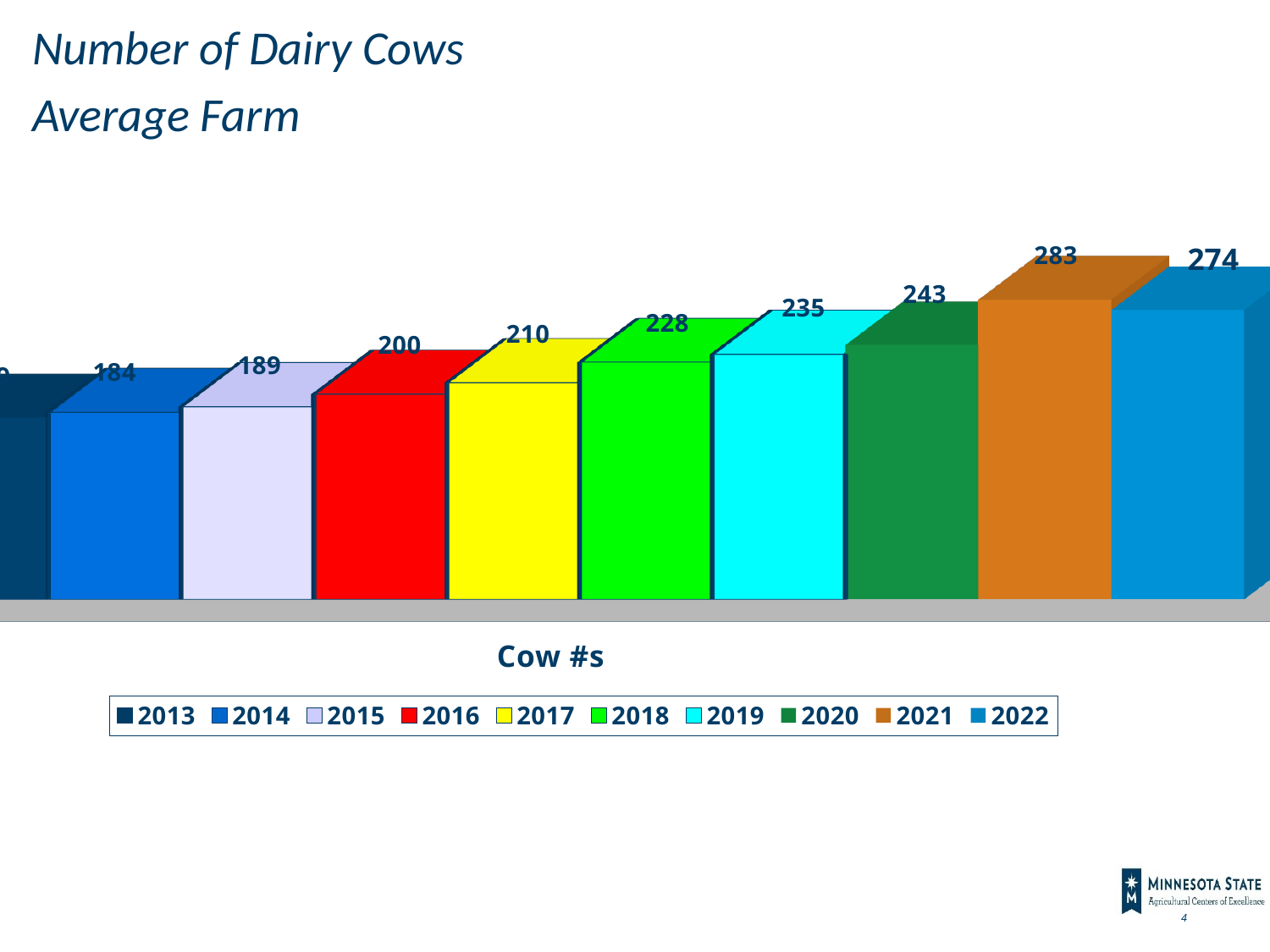
What is the value for 2022? 274 Do the values generally rise or fall from 2014 to 2021? rise What is the value for 2021? 283 What is the title shown below the bars? Cow #s What is the value for 2017? 210 What is the difference between the values for 2021 and 2022? 9 Which is larger, the value for 2019 or the value for 2020? 2020 What kind of chart is shown? bar chart What is the difference between the values for 2022 and 2014? 90 Which year has the highest value? 2021 What is the value for 2014? 184 How many entries does the legend list? 10